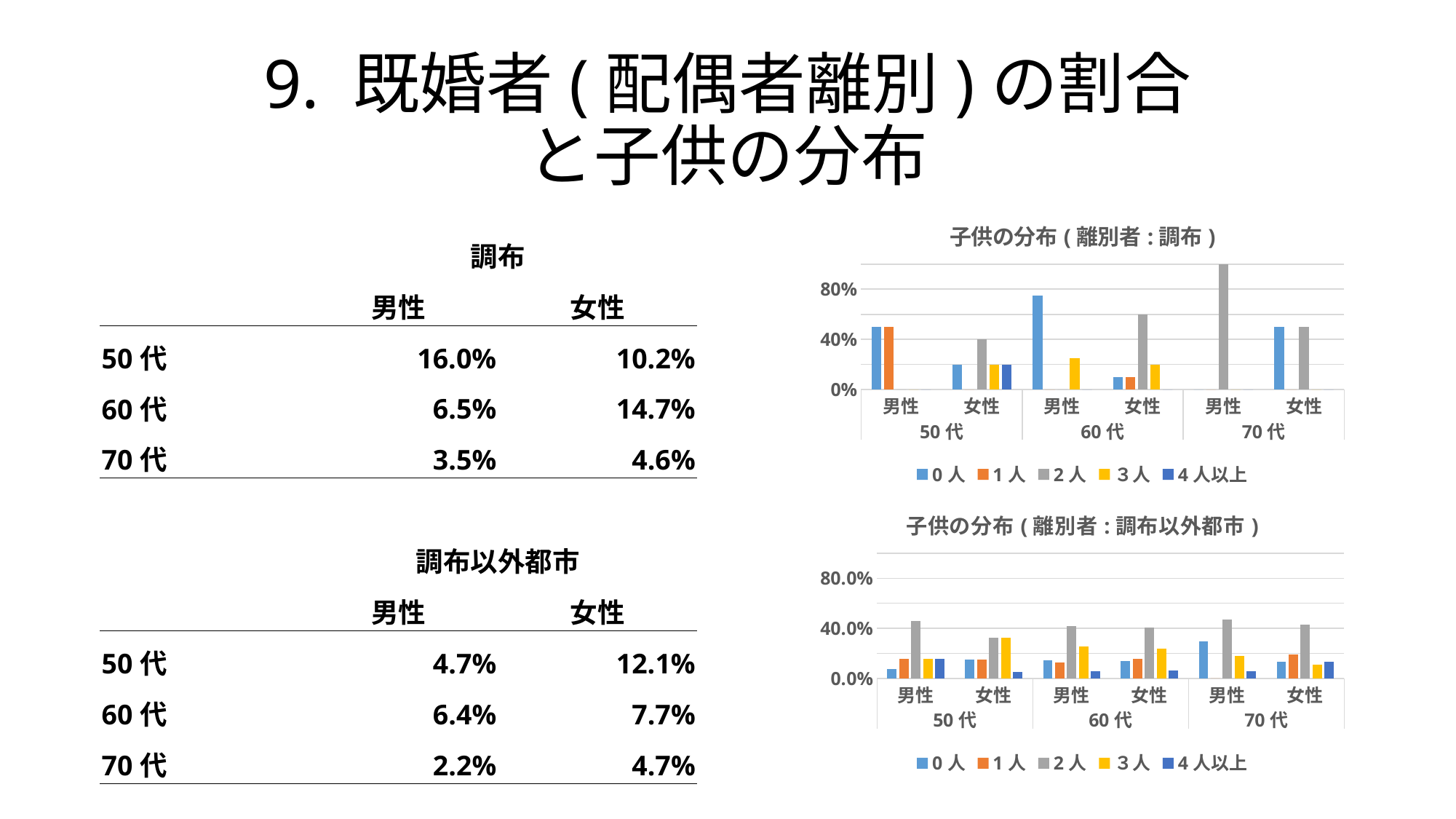
In the chart 子供の分布(離別者:調布), is the value of 0人 for 60代 男性 greater or less than 40%? greater How many age groups are shown on the x axis of the chart 子供の分布(離別者:調布以外都市)? 3 How many series does the legend of the chart 子供の分布(離別者:調布) list? 5 In the chart 子供の分布(離別者:調布以外都市), which is larger for 70代 男性: 0人 or 4人以上? 0人 In the chart 子供の分布(離別者:調布以外都市), which series is represented by the grey bars? 2人 What kind of chart is the bottom-right chart titled 子供の分布(離別者:調布以外都市)? bar chart In the chart 子供の分布(離別者:調布), is the value of 2人 for 70代 男性 greater or less than 80%? greater In the chart 子供の分布(離別者:調布), which category has the tallest bar overall? 70代 男性 (2人) In the chart 子供の分布(離別者:調布以外都市), is the value of 2人 for 50代 男性 greater or less than 40.0%? greater What kind of chart is the top-right chart titled 子供の分布(離別者:調布)? bar chart In the chart 子供の分布(離別者:調布), which is larger for 60代 女性: 2人 or 3人? 2人